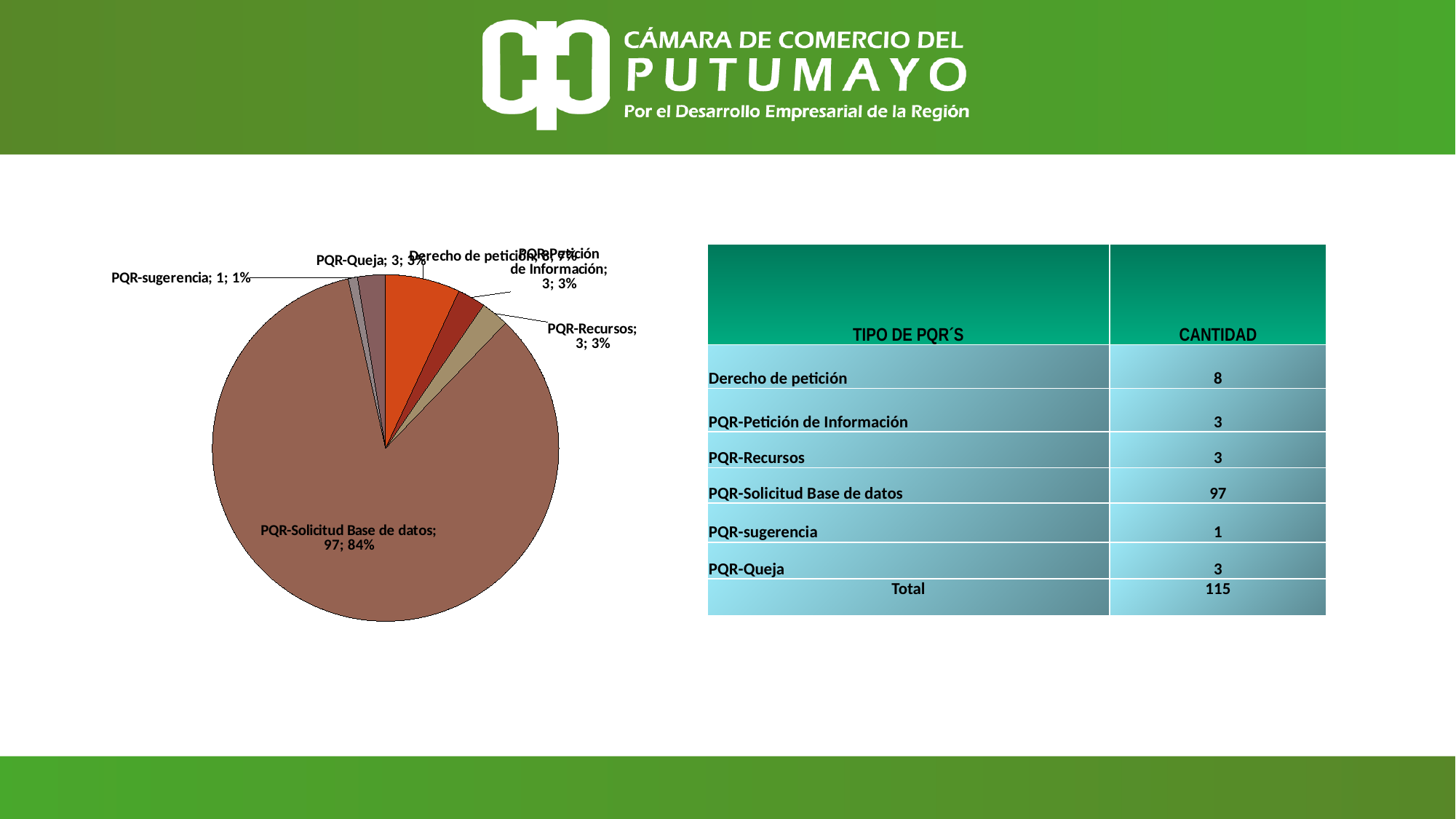
What share of the pie does PQR-Solicitud Base de datos represent? 84% What is the difference between the values for PQR-Solicitud Base de datos and PQR-Queja in the pie chart? 94 How many slices does the pie chart have? 6 Which category has the smallest slice in the pie chart? PQR-sugerencia What is the value shown for PQR-sugerencia in the pie chart? 1 What kind of chart is shown on the slide? pie chart What is the value shown for PQR-Recursos in the pie chart? 3 What share of the pie does PQR-Queja represent? 3% Which category has the largest slice in the pie chart? PQR-Solicitud Base de datos Which is larger in the pie chart, PQR-Queja or PQR-sugerencia? PQR-Queja What is the value shown for PQR-Solicitud Base de datos in the pie chart? 97 What share of the pie does PQR-sugerencia represent? 1%